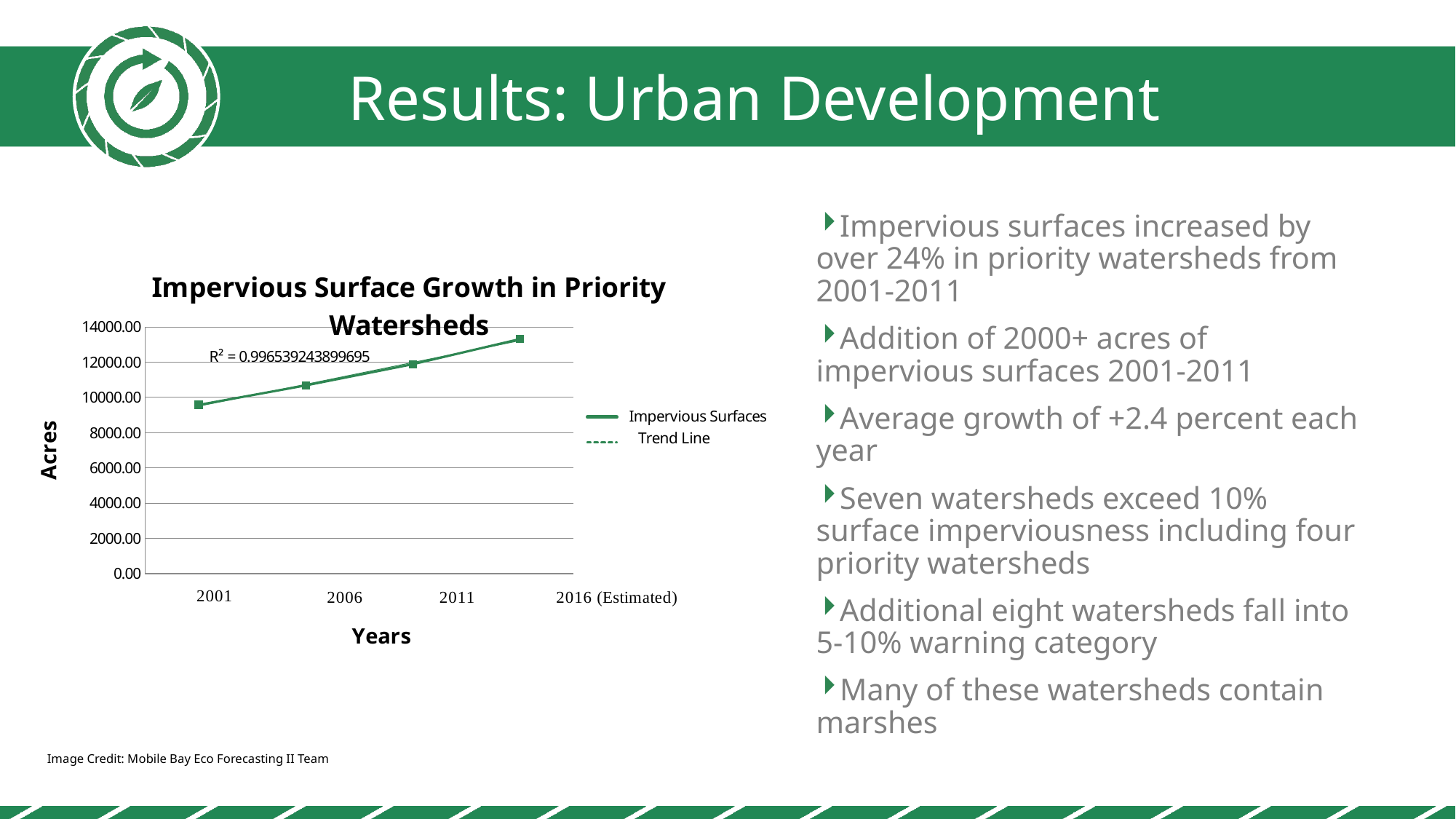
Which year has the lowest impervious surface value? 2001 Is the value for 2016 (Estimated) greater or less than 12000.00 acres? greater What kind of chart is shown on the slide? line chart Which is larger, the value for 2011 or the value for 2006? 2011 Which year has the highest impervious surface value? 2016 (Estimated) Is the value for 2011 greater or less than 10000.00 acres? greater What is the label of the y axis of the chart? Acres How many series does the chart legend list? 2 Is the value for 2001 greater or less than 10000.00 acres? less What is the title of the chart? Impervious Surface Growth in Priority Watersheds Do the impervious surface values rise or fall from 2001 to 2016 (Estimated)? rise How many years are plotted on the x axis of the chart? 4